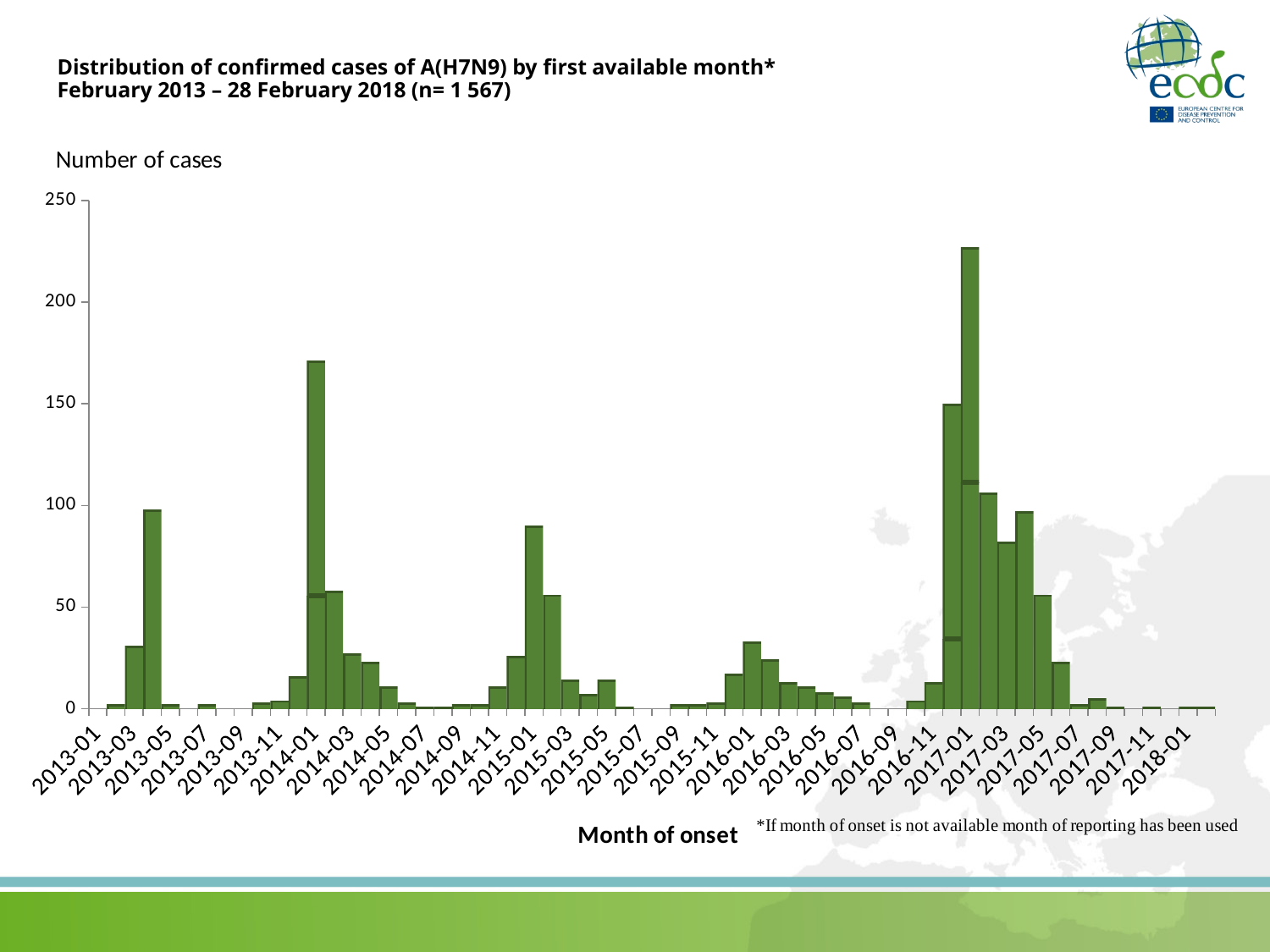
Is the value for 2016-01 greater or less than 50? less Is the value of the tallest bar greater or less than 250? less What is the highest value shown on the y axis? 250 Is the value for 2018-01 greater or less than 50? less Which year contains the tallest bar, 2014 or 2017? 2017 What is the label of the x axis? Month of onset How many month labels are shown on the x axis? 31 What kind of chart is shown on the slide? Bar chart What is the title of the chart? Distribution of confirmed cases of A(H7N9) by first available month* February 2013 – 28 February 2018 (n= 1 567)